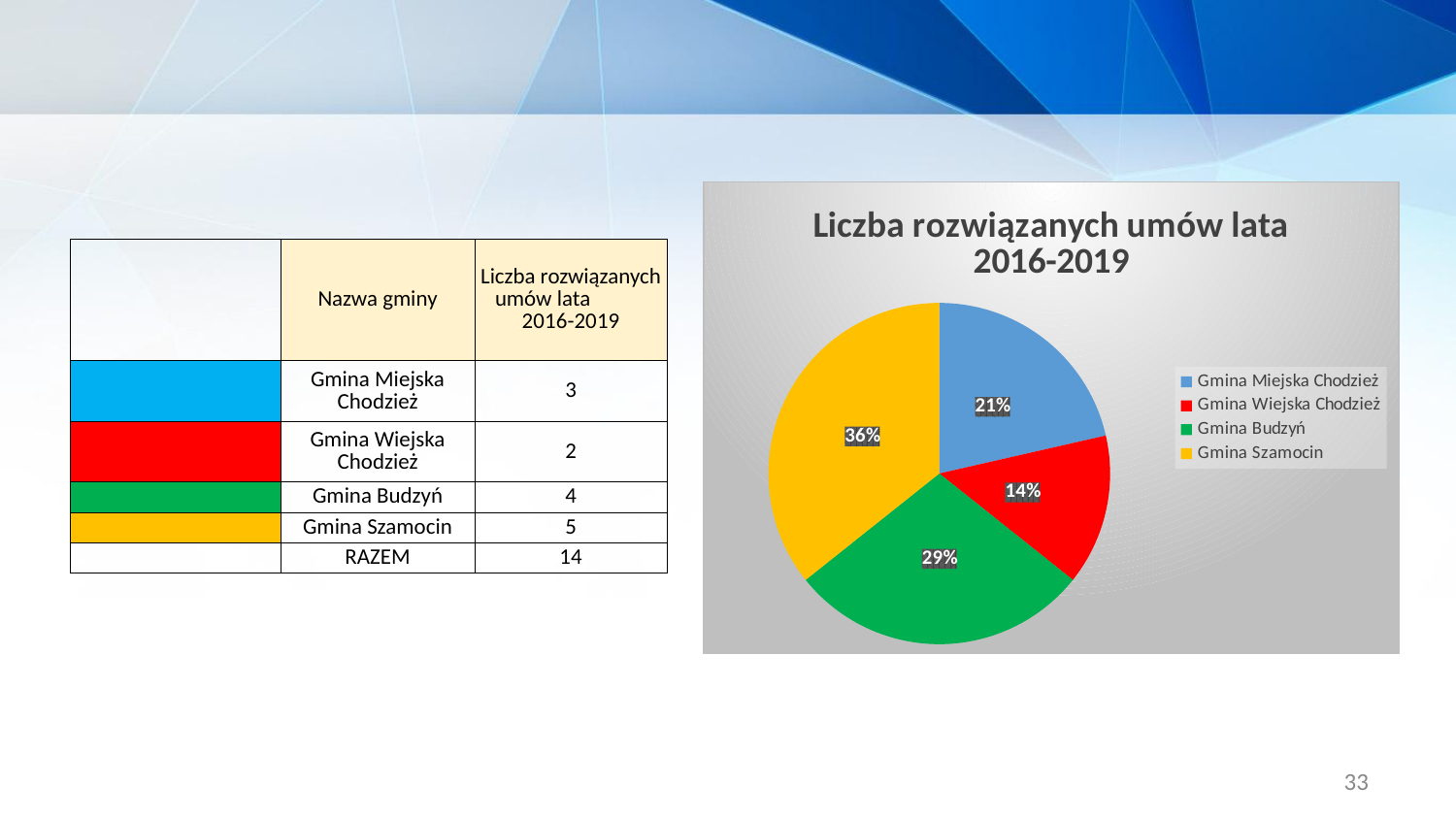
Which slice is larger, Gmina Budzyń or Gmina Miejska Chodzież? Gmina Budzyń What kind of chart is shown on the slide? pie chart What share of the pie does Gmina Miejska Chodzież have? 21% Which category has the largest slice of the pie? Gmina Szamocin Which category has the smallest slice of the pie? Gmina Wiejska Chodzież How many slices does the pie chart have? 4 What is the difference in percentage points between the Gmina Szamocin slice and the Gmina Wiejska Chodzież slice? 22 What is the title of the chart? Liczba rozwiązanych umów lata 2016-2019 What share of the pie does Gmina Budzyń have? 29% What share of the pie does Gmina Wiejska Chodzież have? 14% What colour is the Gmina Budzyń slice in the pie chart? green